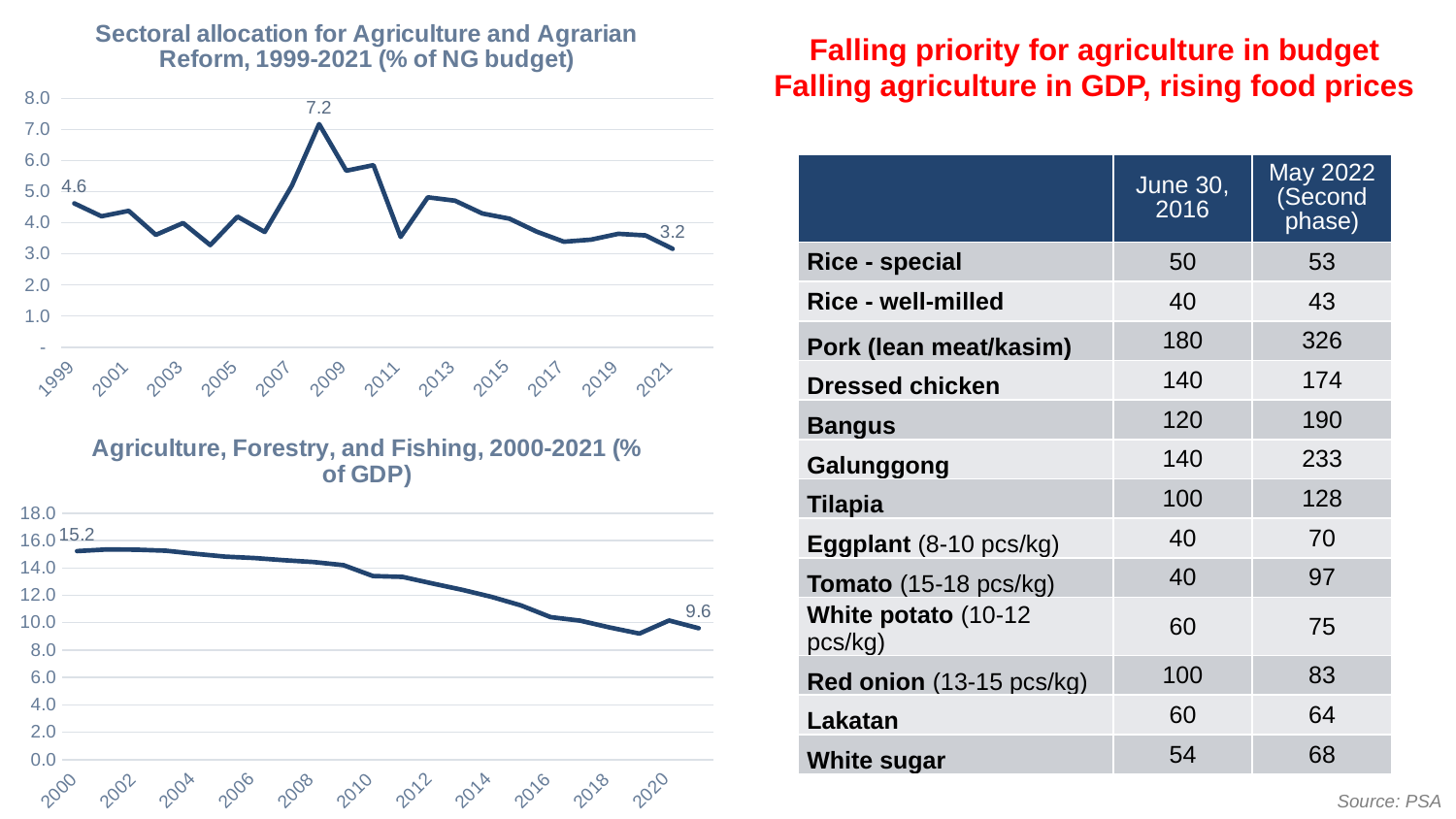
In the top chart (Sectoral allocation for Agriculture and Agrarian Reform), what is the difference between the 1999 value and the 2021 value? 1.4 In the bottom chart (Agriculture, Forestry, and Fishing, % of GDP), is the value for 2016 greater or less than 12.0? less In the bottom chart (Agriculture, Forestry, and Fishing, % of GDP), what is the value for 2021? 9.6 What kind of chart is the top chart (Sectoral allocation for Agriculture and Agrarian Reform)? line chart In the bottom chart (Agriculture, Forestry, and Fishing, % of GDP), do the values generally rise or fall from 2000 to 2021? fall In the bottom chart (Agriculture, Forestry, and Fishing, % of GDP), what is the value for 2000? 15.2 In the top chart (Sectoral allocation for Agriculture and Agrarian Reform), what is the highest value shown? 7.2 In the top chart (Sectoral allocation for Agriculture and Agrarian Reform), what is the value for 2021? 3.2 In the bottom chart (Agriculture, Forestry, and Fishing, % of GDP), what is the difference between the 2000 value and the 2021 value? 5.6 In the top chart (Sectoral allocation for Agriculture and Agrarian Reform), what is the value for 1999? 4.6 In the top chart (Sectoral allocation for Agriculture and Agrarian Reform), which is larger, the value for 1999 or the value for 2021? 1999